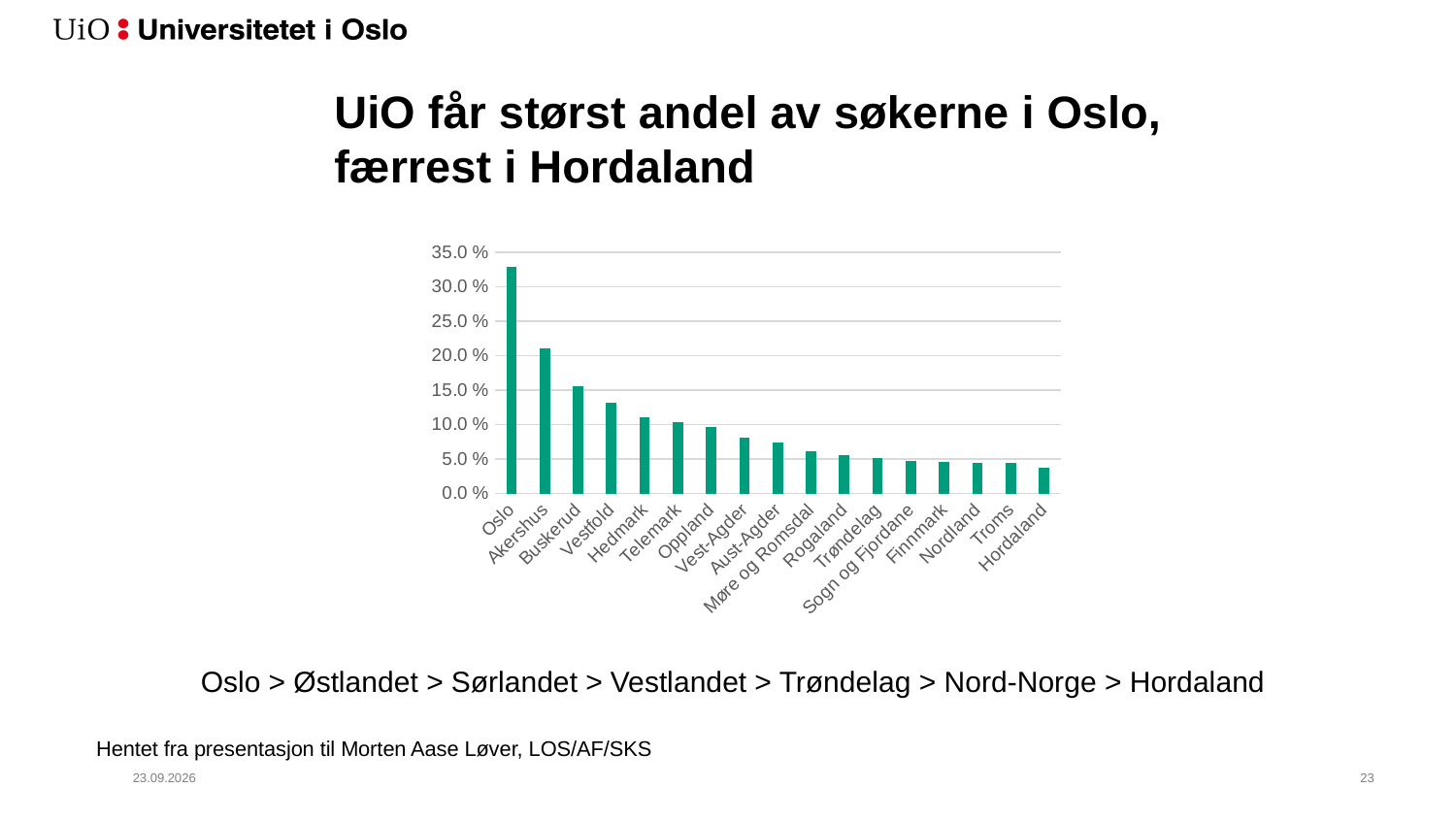
How many counties are shown on the x axis of the chart? 17 What kind of chart is shown on the slide? Bar chart Is the value for Vestfold greater or less than 10.0 %? greater What is the title of the slide containing the chart? UiO får størst andel av søkerne i Oslo, færrest i Hordaland Which county has the lowest value in the chart? Hordaland Which county has the highest value in the chart? Oslo Which is larger, the value for Buskerud or the value for Vestfold? Buskerud Is the value for Akershus greater or less than 20.0 %? greater Do the values rise or fall from left to right along the x axis? Fall Is the value for Oslo greater or less than 30.0 %? greater